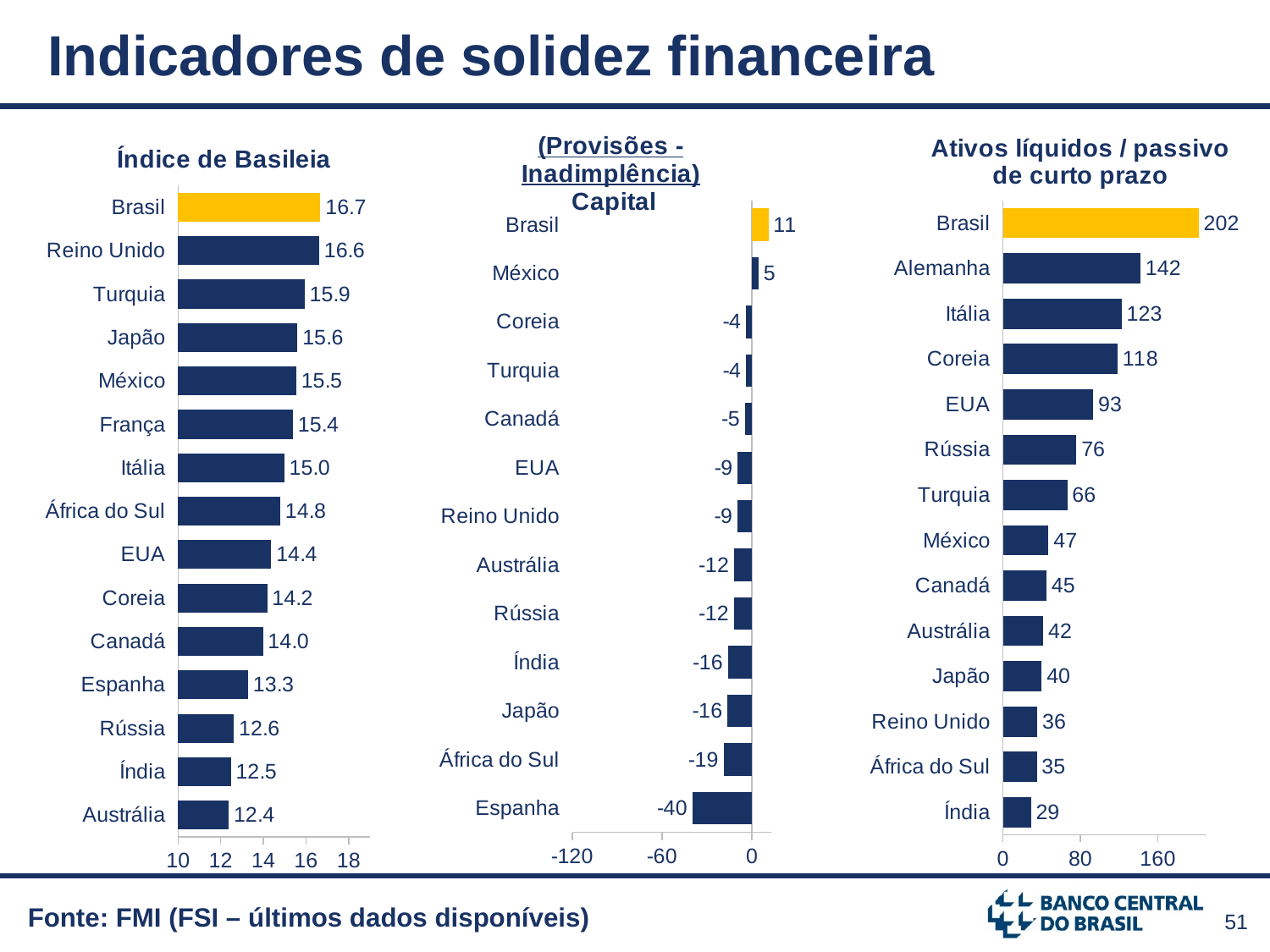
In the 'Índice de Basileia' chart, what is the difference between Brasil and Austrália? 4.3 In the '(Provisões - Inadimplência) / Capital' chart, what is the value for Espanha? -40 In the '(Provisões - Inadimplência) / Capital' chart, what is the value for Japão? -16 In the 'Ativos líquidos / passivo de curto prazo' chart, which is larger, the value for EUA or the value for Rússia? EUA In the 'Índice de Basileia' chart, what is the value for Brasil? 16.7 In the '(Provisões - Inadimplência) / Capital' chart, which country has the highest value? Brasil In the 'Índice de Basileia' chart, how many countries are shown? 15 In the 'Índice de Basileia' chart, which country has the lowest value? Austrália In the 'Ativos líquidos / passivo de curto prazo' chart, what is the difference between Brasil and Alemanha? 60 In the 'Ativos líquidos / passivo de curto prazo' chart, what is the value for Alemanha? 142 In the 'Ativos líquidos / passivo de curto prazo' chart, which country has the lowest value? Índia What kind of chart is the 'Índice de Basileia' chart? Bar chart